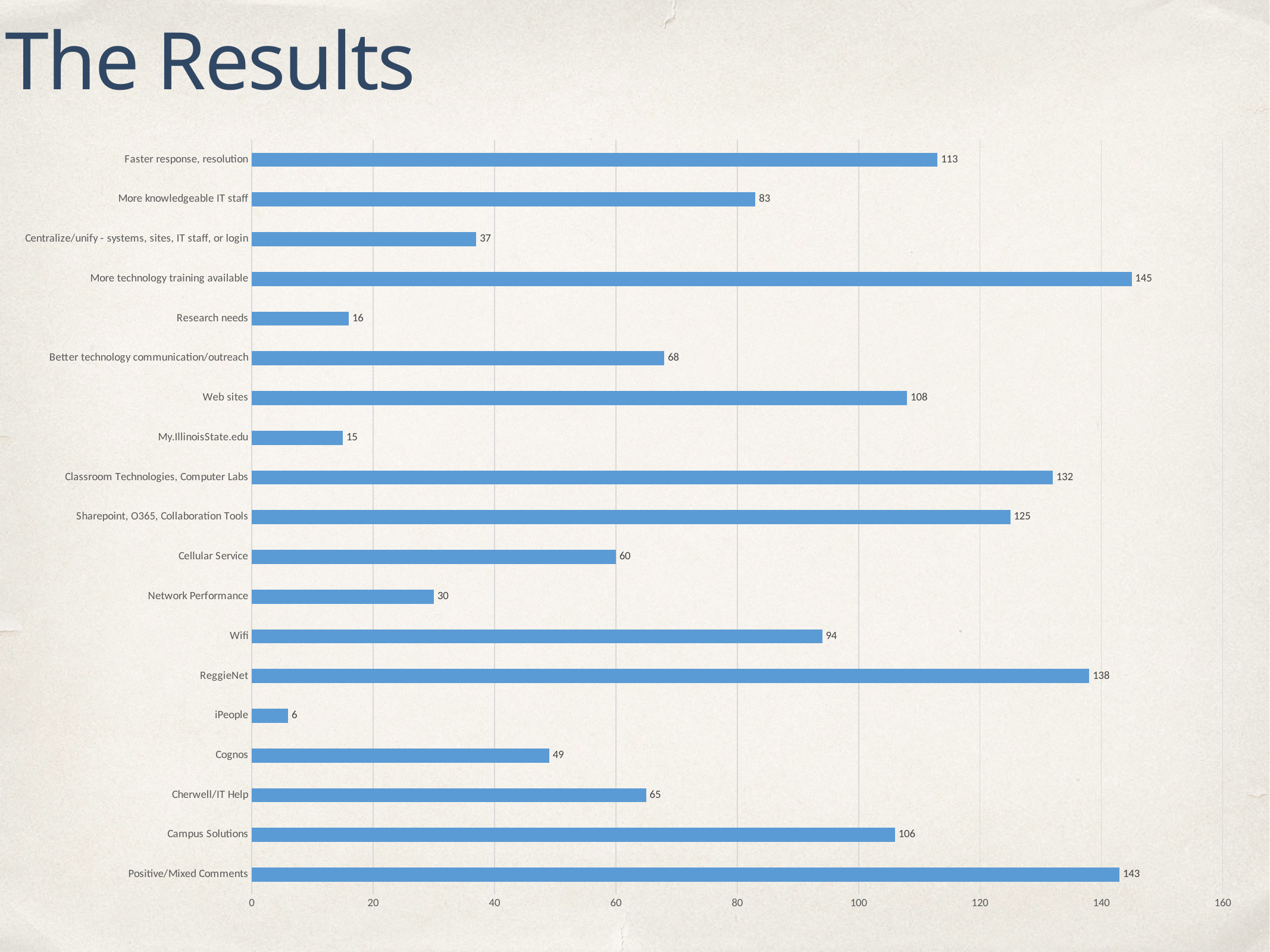
Which category has the highest value? More technology training available What is the difference between the values for Positive/Mixed Comments and Campus Solutions? 37 What is the title of the slide? The Results What kind of chart is shown on the slide? Bar chart How many categories are shown in the chart? 19 Is the value for Classroom Technologies, Computer Labs greater or less than 120? greater Which is larger, the value for Wifi or the value for More knowledgeable IT staff? Wifi What is the value for Centralize/unify - systems, sites, IT staff, or login? 37 What is the value for ReggieNet? 138 What is the value for Cellular Service? 60 Which category has the lowest value? iPeople What is the difference between the values for Web sites and Cherwell/IT Help? 43